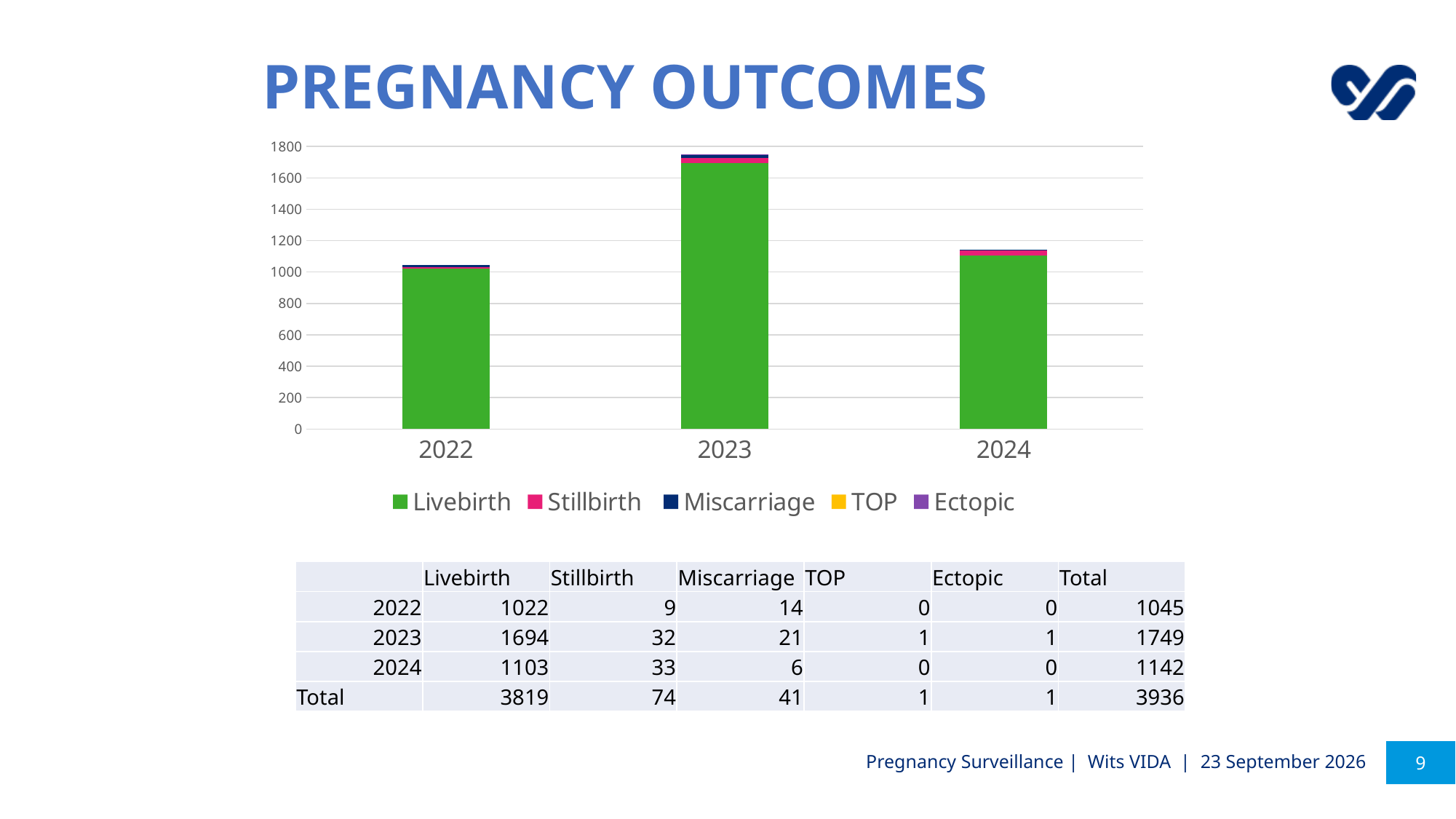
What is the total of the stacked bar for 2022? 1045 What kind of chart is shown on the slide? Stacked bar chart How many series does the chart legend list? 5 What is the Livebirth value for 2023? 1694 Which is larger, the Miscarriage value for 2022 or for 2024? 2022 How many years are shown on the x axis of the chart? 3 What is the difference between the Livebirth values for 2023 and 2024? 591 What is the Stillbirth value for 2024? 33 Which year has the shortest stacked bar? 2022 Is the total for 2024 greater or less than 1200? less Which series is shown in green in the chart? Livebirth Which year has the tallest stacked bar? 2023